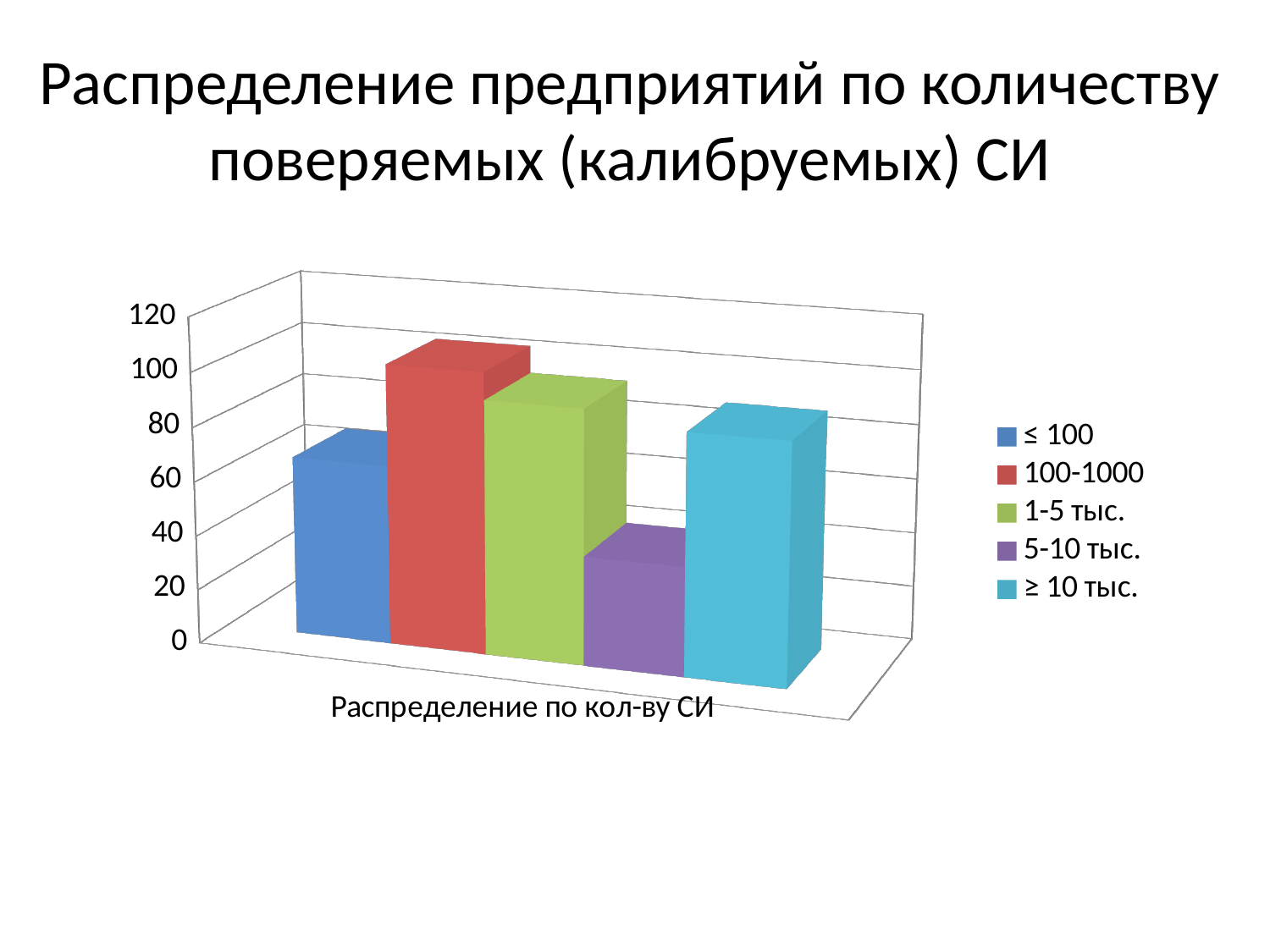
What is the category label shown under the bars? Распределение по кол-ву СИ Which series has the lowest bar? 5-10 тыс. Which series has the highest bar? 100-1000 Is the value for ≤ 100 greater or less than 40? greater How many categories are shown on the x axis? 1 Is the value for 100-1000 greater or less than 80? greater What kind of chart is shown on the slide? bar chart Is the value for 5-10 тыс. greater or less than 60? less Which is larger, the value for ≤ 100 or the value for 100-1000? 100-1000 What is the title of the slide? Распределение предприятий по количеству поверяемых (калибруемых) СИ How many series does the legend list? 5 Which is larger, the value for 1-5 тыс. or the value for 5-10 тыс.? 1-5 тыс.